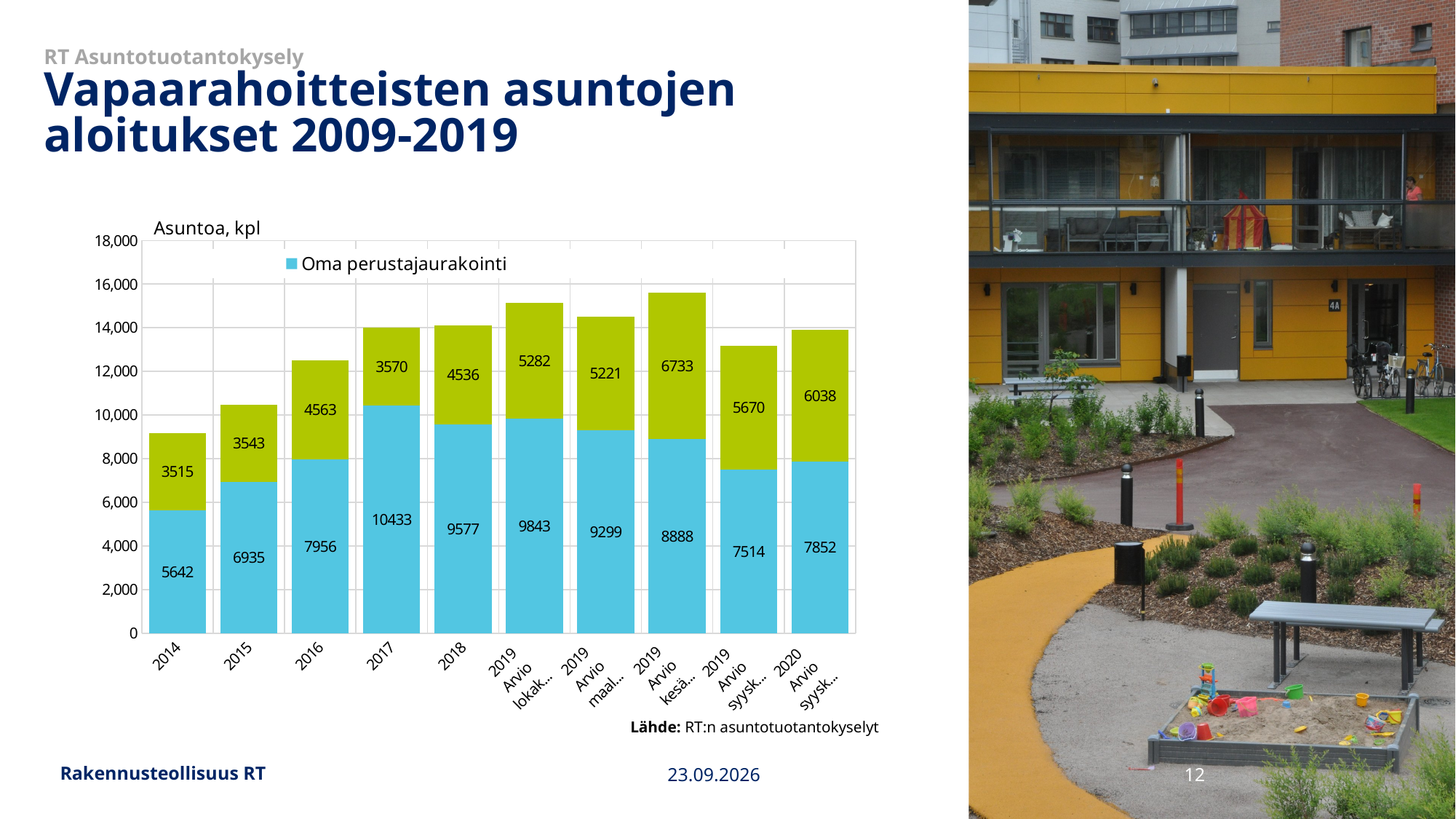
What is the Oma perustajaurakointi value for the bar labelled 2019 Arvio kesä…? 8888 What type of chart is shown on the slide? stacked bar chart How many series does the legend list? 1 What is the Oma perustajaurakointi value for 2017? 10433 How many bars are shown in the chart? 10 What is the value of the upper (green) segment for 2016? 4563 Is the Oma perustajaurakointi value for 2015 larger or smaller than for 2016? smaller Which bar has the highest Oma perustajaurakointi value? 2017 Which bar has the lowest Oma perustajaurakointi value? 2014 Which bar has the largest upper (green) segment? 2019 Arvio kesä… What is the total of the stacked bar for 2014? 9157 What is the difference between the Oma perustajaurakointi values for 2017 and 2018? 856